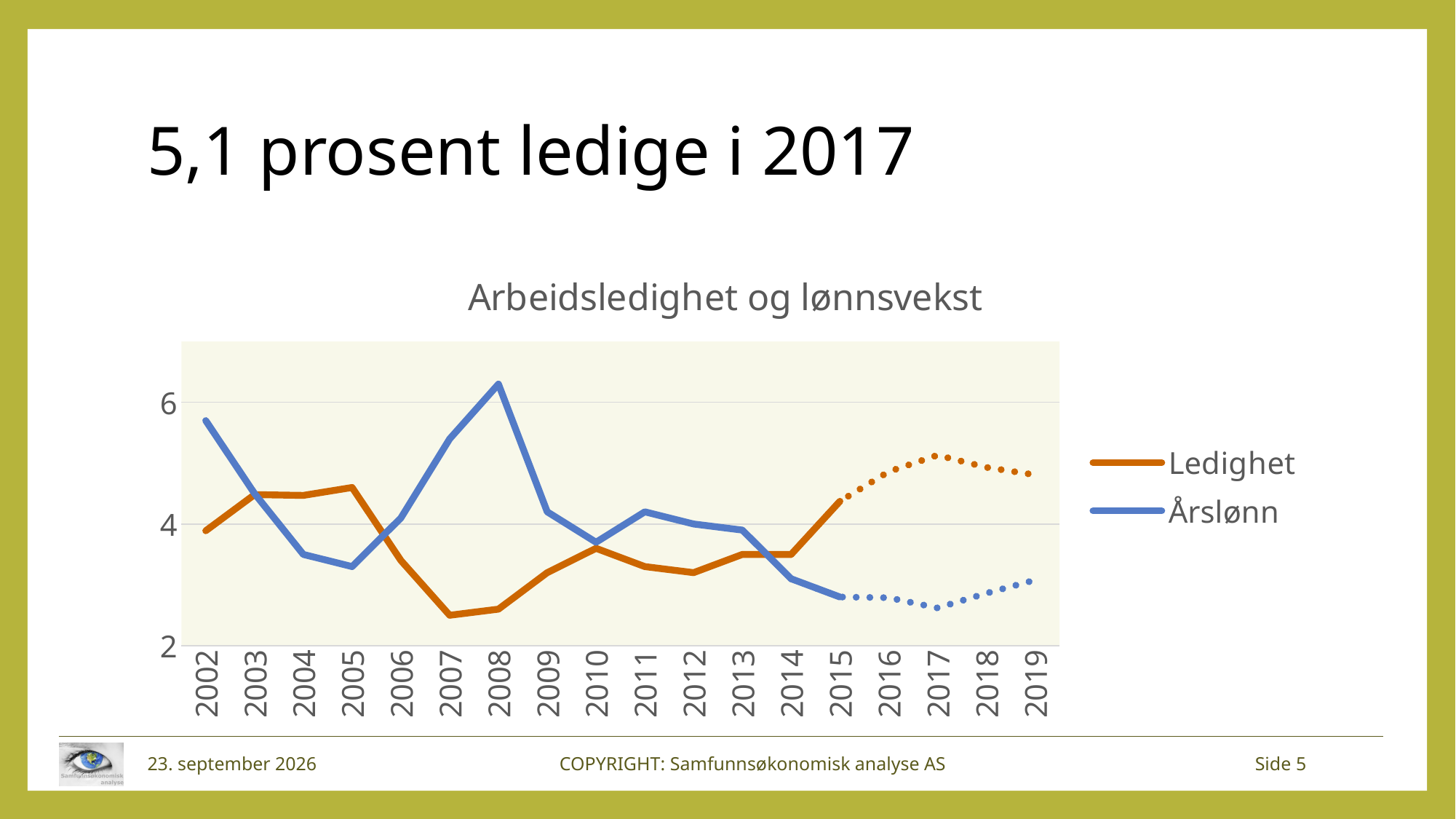
In which year does the Ledighet series reach its lowest value? 2007 Which colour is used for the Ledighet series? orange What kind of chart is shown on the slide? line chart Is the value for Ledighet in 2007 greater or less than 4? less How many years are shown on the x axis? 18 Is the value for Årslønn in 2008 greater or less than 6? greater How many series does the legend list? 2 Is the value for Årslønn in 2017 greater or less than 4? less In 2008, which series has the larger value, Ledighet or Årslønn? Årslønn What is the title of the chart? Arbeidsledighet og lønnsvekst Does the Ledighet series rise or fall from 2014 to 2017? rise In which year does the Årslønn series reach its highest value? 2008